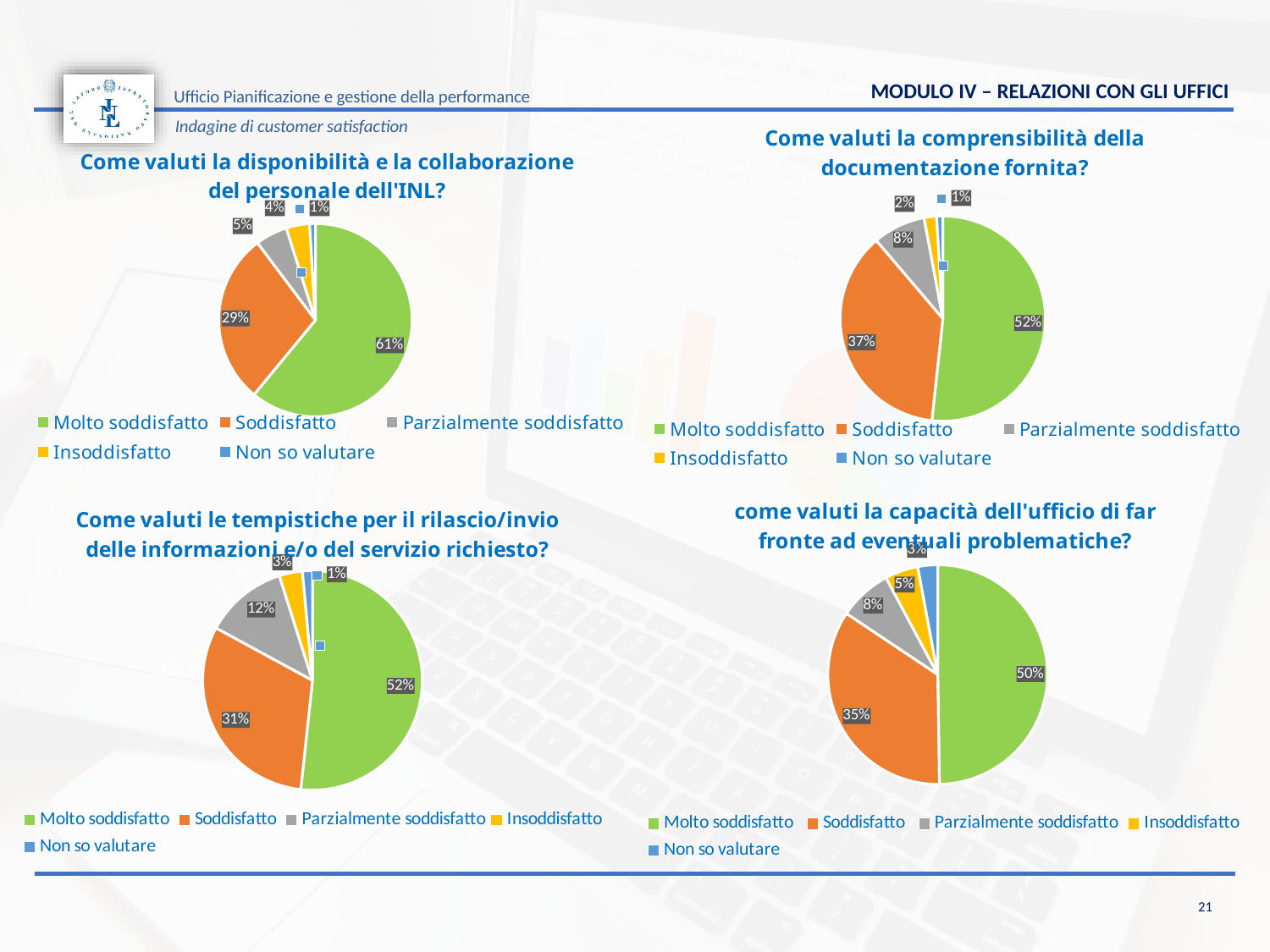
In the chart titled "come valuti la capacità dell'ufficio di far fronte ad eventuali problematiche?", what percentage is Soddisfatto? 35% In the chart titled "Come valuti le tempistiche per il rilascio/invio delle informazioni e/o del servizio richiesto?", what percentage is Parzialmente soddisfatto? 12% What type of chart is used for "Come valuti le tempistiche per il rilascio/invio delle informazioni e/o del servizio richiesto?"? Pie chart In the chart titled "Come valuti la comprensibilità della documentazione fornita?", which category has the largest share? Molto soddisfatto In the chart titled "Come valuti le tempistiche per il rilascio/invio delle informazioni e/o del servizio richiesto?", which category has the smallest share? Non so valutare In the chart titled "Come valuti la disponibilità e la collaborazione del personale dell'INL?", what percentage is Soddisfatto? 29% In the chart titled "Come valuti la disponibilità e la collaborazione del personale dell'INL?", what colour represents Soddisfatto? Orange How many categories does the legend list for the chart titled "Come valuti la comprensibilità della documentazione fornita?"? 5 In the chart titled "come valuti la capacità dell'ufficio di far fronte ad eventuali problematiche?", what is the difference between Molto soddisfatto and Soddisfatto? 15 percentage points In the chart titled "Come valuti la comprensibilità della documentazione fornita?", what percentage is Parzialmente soddisfatto? 8% In the chart titled "Come valuti la disponibilità e la collaborazione del personale dell'INL?", which is larger, Parzialmente soddisfatto or Insoddisfatto? Parzialmente soddisfatto In the chart titled "Come valuti la disponibilità e la collaborazione del personale dell'INL?", what percentage is Molto soddisfatto? 61%